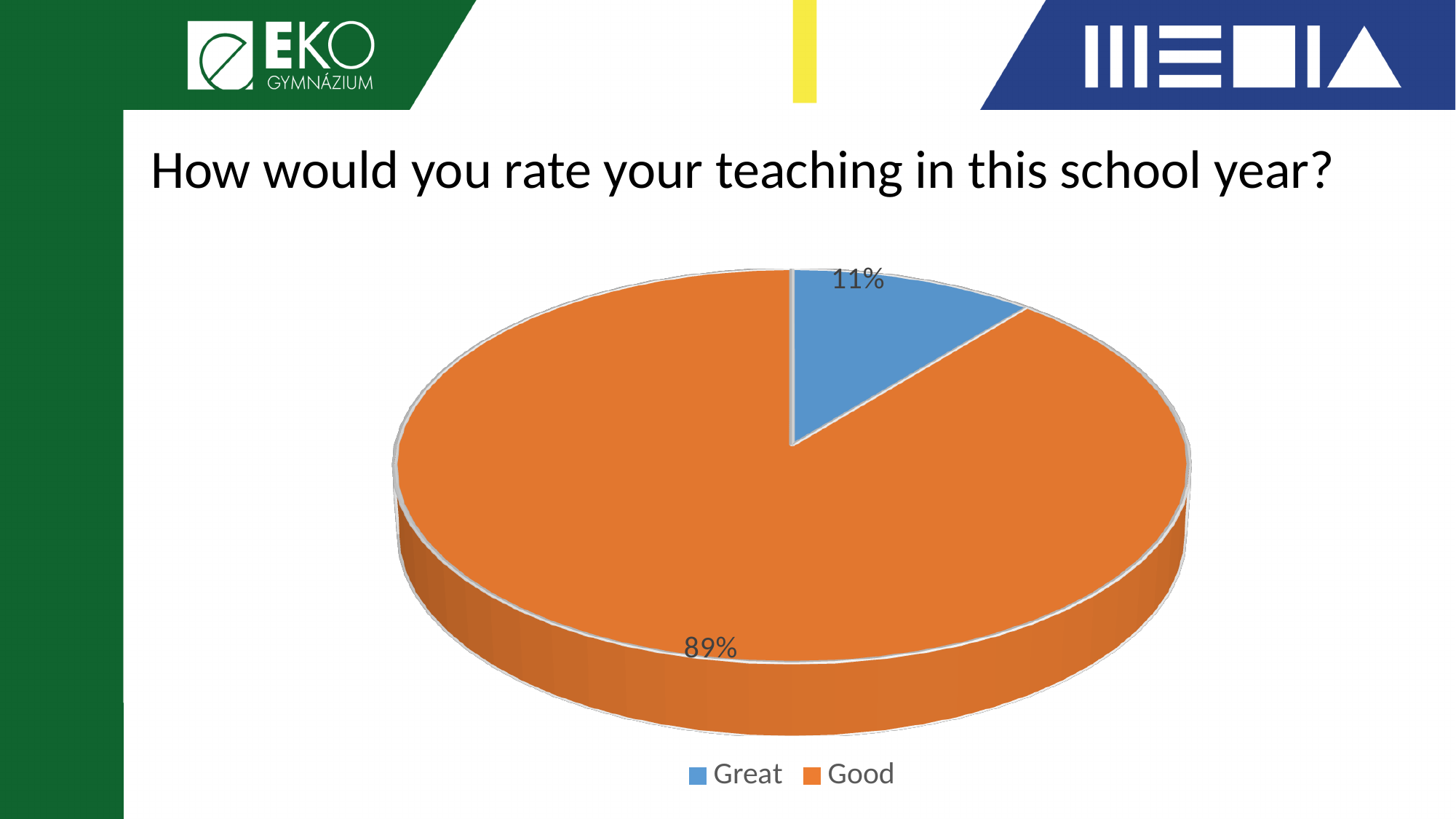
How many slices does the pie chart have? 2 What share of the pie is labelled "Great"? 11% Which slice is larger, "Great" or "Good"? Good Which category has the smallest slice of the pie? Great How many entries does the legend list? 2 What share of the pie is labelled "Good"? 89% Which category has the largest slice of the pie? Good What is the difference in percentage points between the "Good" and "Great" slices? 78 What kind of chart is shown on the slide? Pie chart What question is the chart on the slide answering? How would you rate your teaching in this school year? What colour is the "Good" slice? Orange